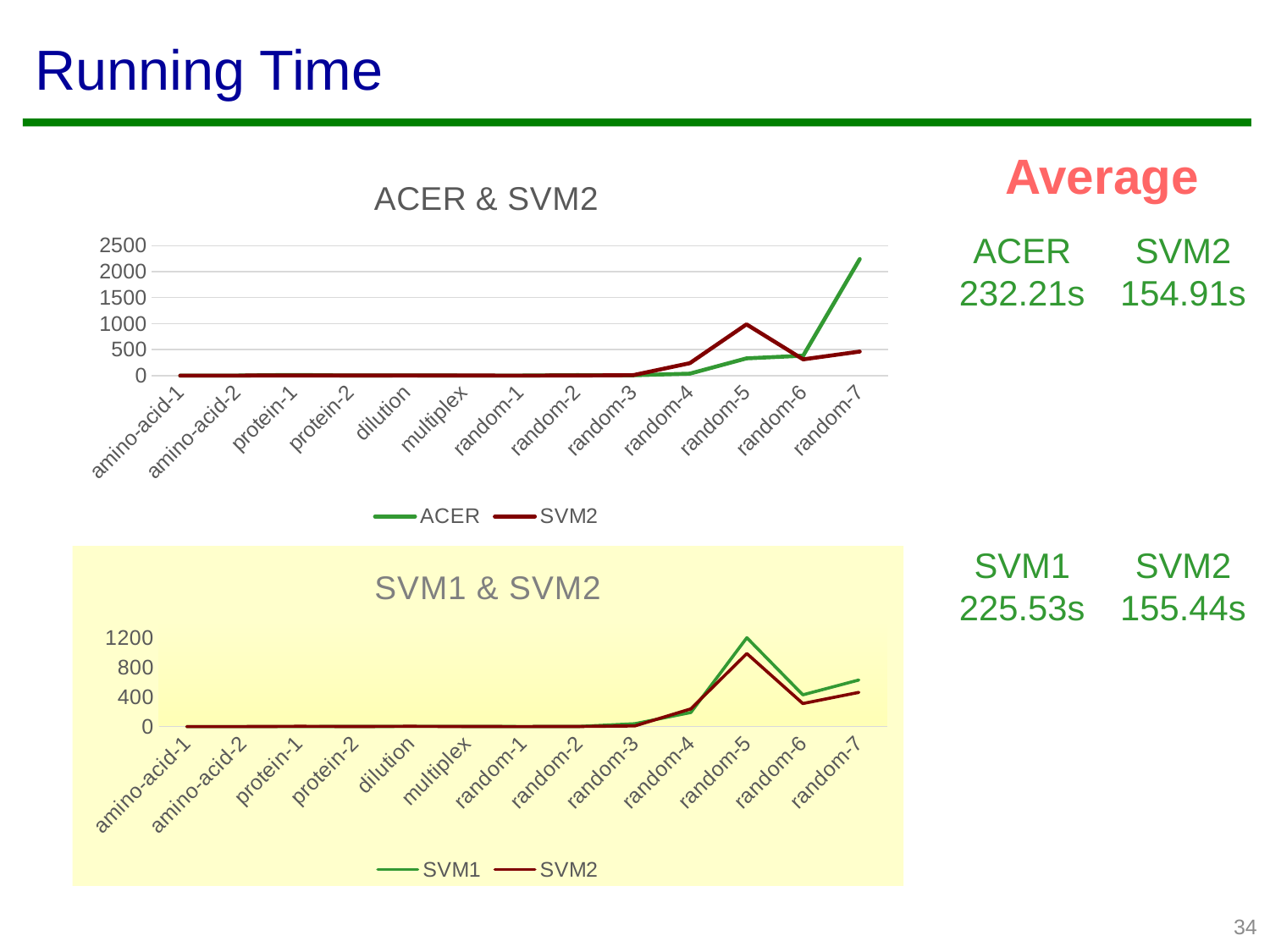
In the "SVM1 & SVM2" chart, is the SVM2 value for random-6 greater or less than 400? less In the "ACER & SVM2" chart, is the SVM2 value for random-5 greater or less than 500? greater In the "ACER & SVM2" chart, at random-5, which series has the larger value, ACER or SVM2? SVM2 What kind of chart is the "ACER & SVM2" chart? line chart In the "ACER & SVM2" chart, which category has the highest ACER value? random-7 What are the two series listed in the legend of the "SVM1 & SVM2" chart? SVM1 and SVM2 In the "ACER & SVM2" chart, which category has the highest SVM2 value? random-5 How many categories are shown on the x axis of the "SVM1 & SVM2" chart? 13 In the "SVM1 & SVM2" chart, which category has the highest SVM1 value? random-5 In the "SVM1 & SVM2" chart, at random-5, which series has the larger value, SVM1 or SVM2? SVM1 How many series does the legend of the "ACER & SVM2" chart list? 2 In the "ACER & SVM2" chart, is the ACER value for random-7 greater or less than 1500? greater